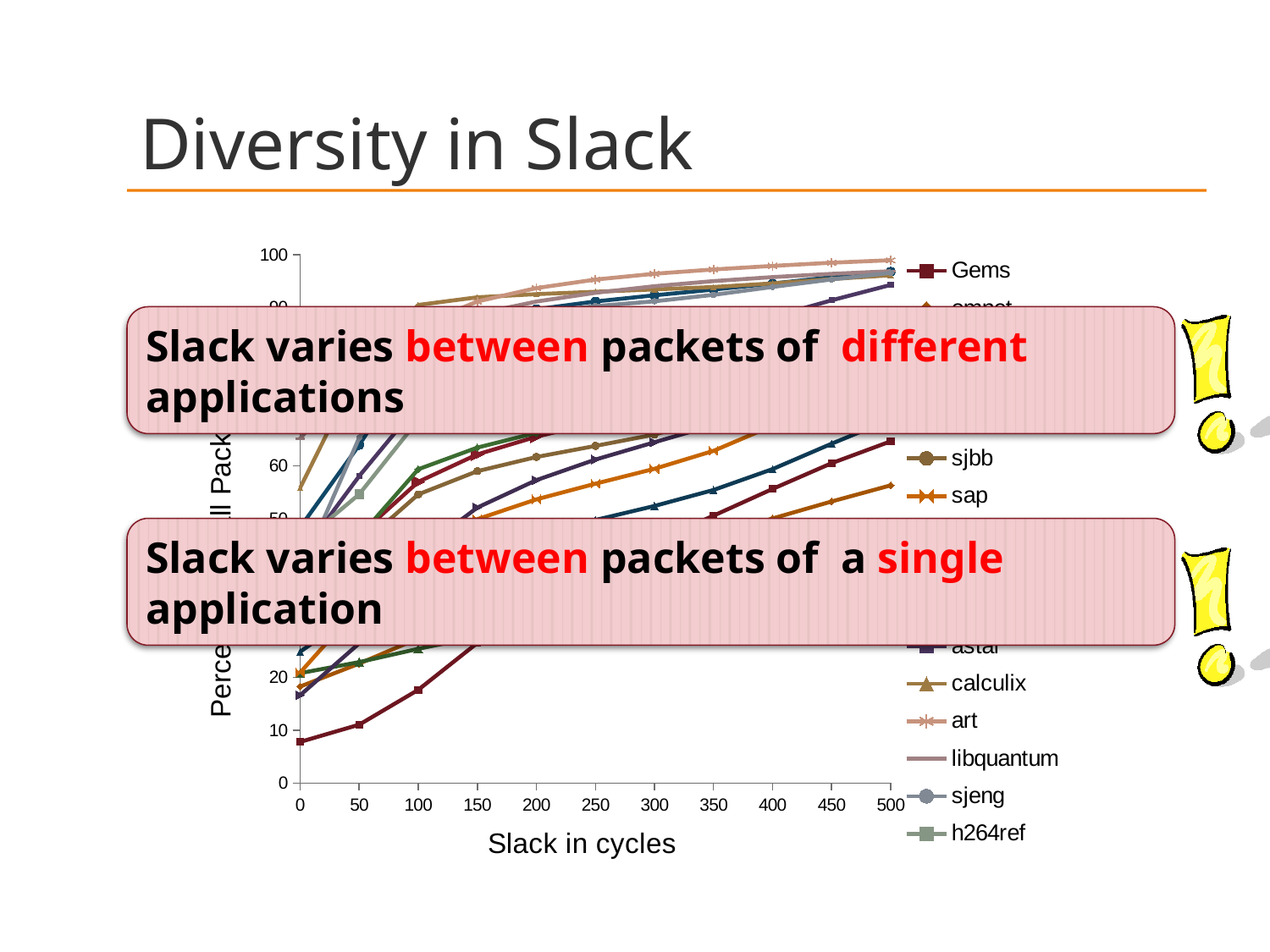
Is the value for art at a slack of 500 cycles greater or less than 90? greater How many tick values are labelled along the x axis of the chart? 11 Is the value for Gems at a slack of 0 cycles greater or less than 10? less What is the label of the x axis of the chart? Slack in cycles As slack in cycles increases, does the Gems line rise or fall? rise At a slack of 500 cycles, which series has the larger value, art or sap? art At a slack of 0 cycles, which series has the larger value, sap or Gems? sap What kind of chart is shown on the slide? line chart Is the value for Gems at a slack of 100 cycles greater or less than 20? less What is the highest value shown on the x axis of the chart? 500